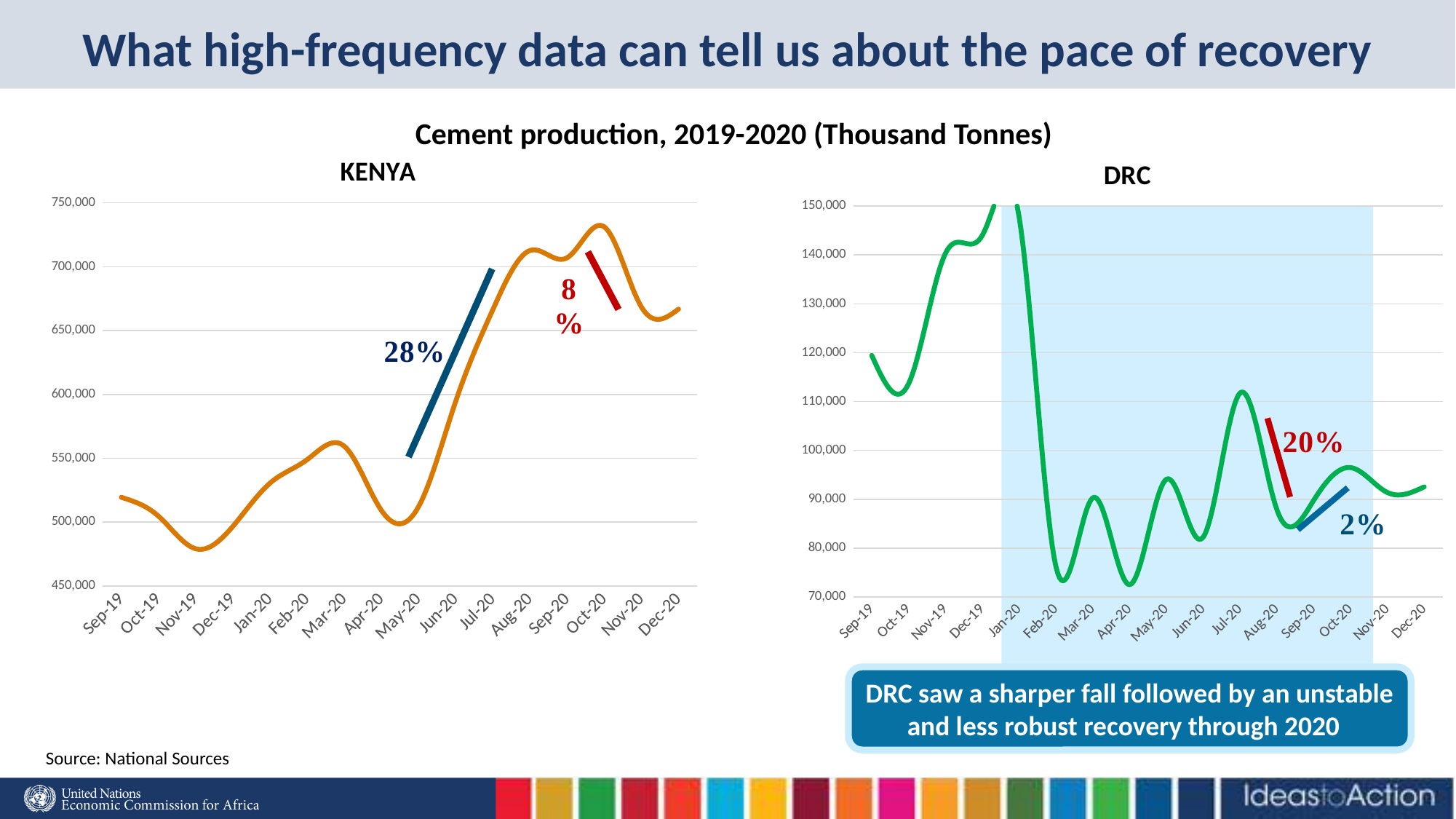
On the DRC chart, is the value for Feb-20 greater or less than 80,000? less On the KENYA chart, which month has the lowest cement production? Nov-19 What percentage change is annotated on the rising segment of the KENYA chart? 28% On the DRC chart, do values rise or fall from Jan-20 to Feb-20? Fall On the KENYA chart, is the value for Nov-19 greater or less than 500,000? less On the DRC chart, is the value for Sep-19 greater or less than 110,000? greater How many monthly points are plotted on the DRC chart's x axis? 16 On the KENYA chart, which month has the highest cement production? Oct-20 What percentage change is annotated in red on the DRC chart? 20% On the DRC chart, which is larger, the value for Sep-19 or the value for Dec-20? Sep-19 What kind of chart is the KENYA chart? Line chart